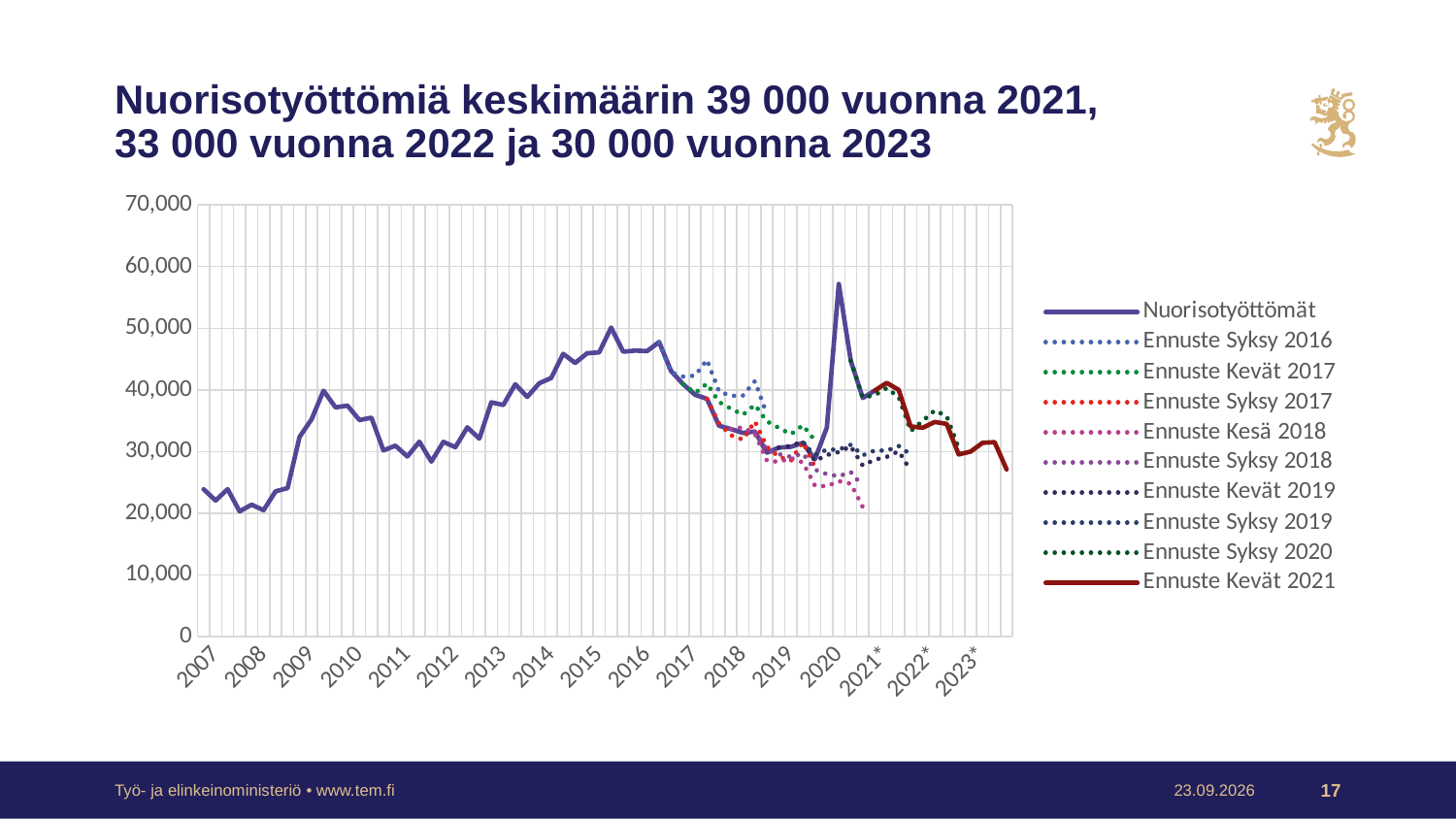
Is the peak value of the Nuorisotyöttömät series in 2020 greater or less than 50,000? greater Does the Nuorisotyöttömät series rise or fall between 2008 and 2009? rise Is the value of the Nuorisotyöttömät series at the start of 2007 greater or less than 30,000? less How many series does the legend list? 10 In which year does the Nuorisotyöttömät series reach its highest value? 2020 How many year labels are shown on the x axis? 17 Which is larger: the peak of the Nuorisotyöttömät series in 2015 or its peak in 2020? 2020 Is the lowest point of the Ennuste Kesä 2018 series greater or less than 30,000? less Which series is drawn as a solid dark red line? Ennuste Kevät 2021 According to the slide title, what is the average number of young unemployed forecast for 2022? 33 000 What kind of chart is shown on the slide? line chart